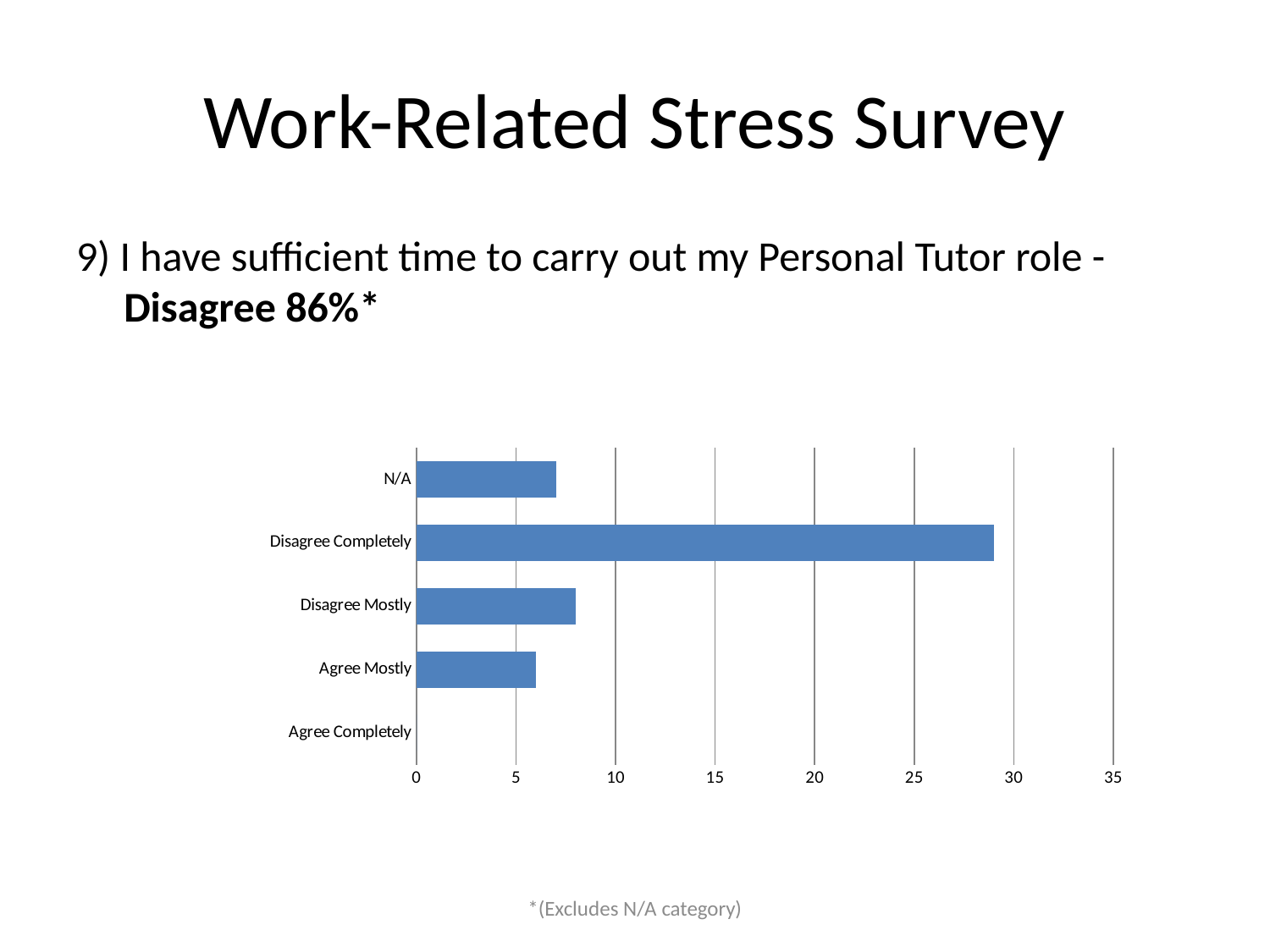
What kind of chart is shown on the slide? bar chart Which category has the lowest value on the chart? Agree Completely Which category has the highest value on the chart? Disagree Completely Which is larger, the value for Disagree Completely or the value for Disagree Mostly? Disagree Completely Is the value for Disagree Mostly greater or less than 10? less Which is larger, the value for Agree Mostly or the value for Disagree Completely? Disagree Completely Is the value for N/A greater or less than 5? greater What colour are the bars on the chart? blue Is the value for Agree Mostly greater or less than 10? less How many categories are shown on the chart? 5 What is the value for Agree Completely? 0